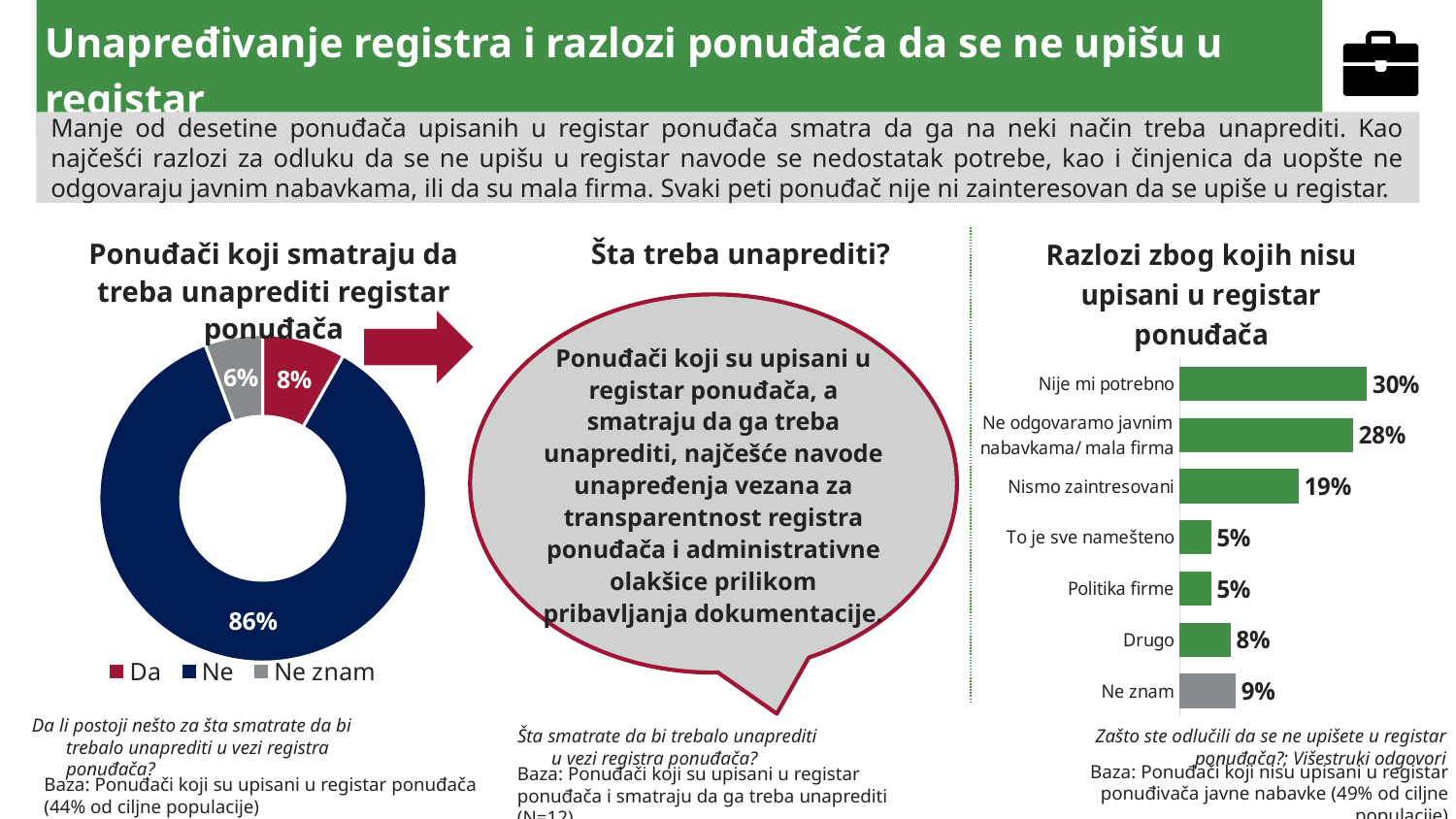
In the chart "Razlozi zbog kojih nisu upisani u registar ponuđača", what is the value for "Nismo zaintresovani"? 19% In the donut chart on the left, what percentage of respondents answered "Ne"? 86% In the chart "Razlozi zbog kojih nisu upisani u registar ponuđača", which is larger: "Drugo" or "Ne znam"? Ne znam In the donut chart on the left, what percentage of respondents answered "Da"? 8% In the chart "Razlozi zbog kojih nisu upisani u registar ponuđača", which reason has the highest value? Nije mi potrebno In the chart "Razlozi zbog kojih nisu upisani u registar ponuđača", what is the value for "Nije mi potrebno"? 30% In the donut chart on the left, what percentage of respondents answered "Ne znam"? 6% In the donut chart on the left, how many categories does the legend list? 3 In the chart "Razlozi zbog kojih nisu upisani u registar ponuđača", how many reasons (bars) are shown? 7 In the donut chart on the left, what is the difference between the "Da" and "Ne znam" shares? 2% What type of chart is "Razlozi zbog kojih nisu upisani u registar ponuđača"? Bar chart In the chart "Razlozi zbog kojih nisu upisani u registar ponuđača", what is the difference between "Nije mi potrebno" and "Ne odgovaramo javnim nabavkama/ mala firma"? 2%